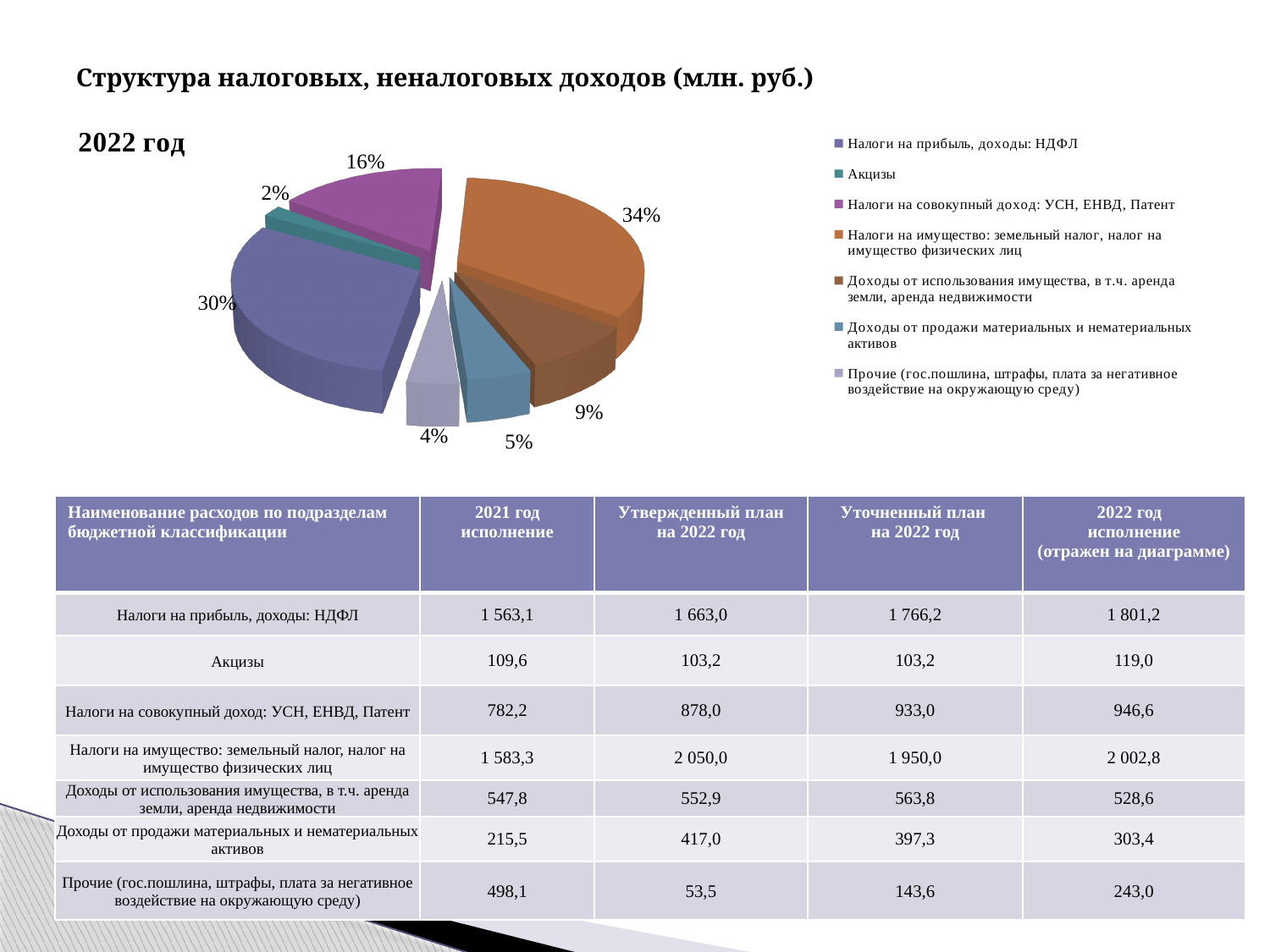
What is the difference in percentage points between the share for "Налоги на имущество" and the share for "Налоги на прибыль, доходы: НДФЛ"? 4 percentage points What share of the pie does "Доходы от использования имущества, в т.ч. аренда земли, аренда недвижимости" have? 9% What share of the pie does "Налоги на прибыль, доходы: НДФЛ" have? 30% Which category has the largest slice of the pie? Налоги на имущество: земельный налог, налог на имущество физических лиц How many categories does the legend of the pie chart list? 7 What share of the pie does "Акцизы" have? 2% What kind of chart is shown on the slide? pie chart Which year does the pie chart represent, according to the label next to it? 2022 год Which category has the smallest slice of the pie? Акцизы Which has a larger share of the pie: "Доходы от продажи материальных и нематериальных активов" or "Прочие (гос.пошлина, штрафы, плата за негативное воздействие на окружающую среду)"? Доходы от продажи материальных и нематериальных активов